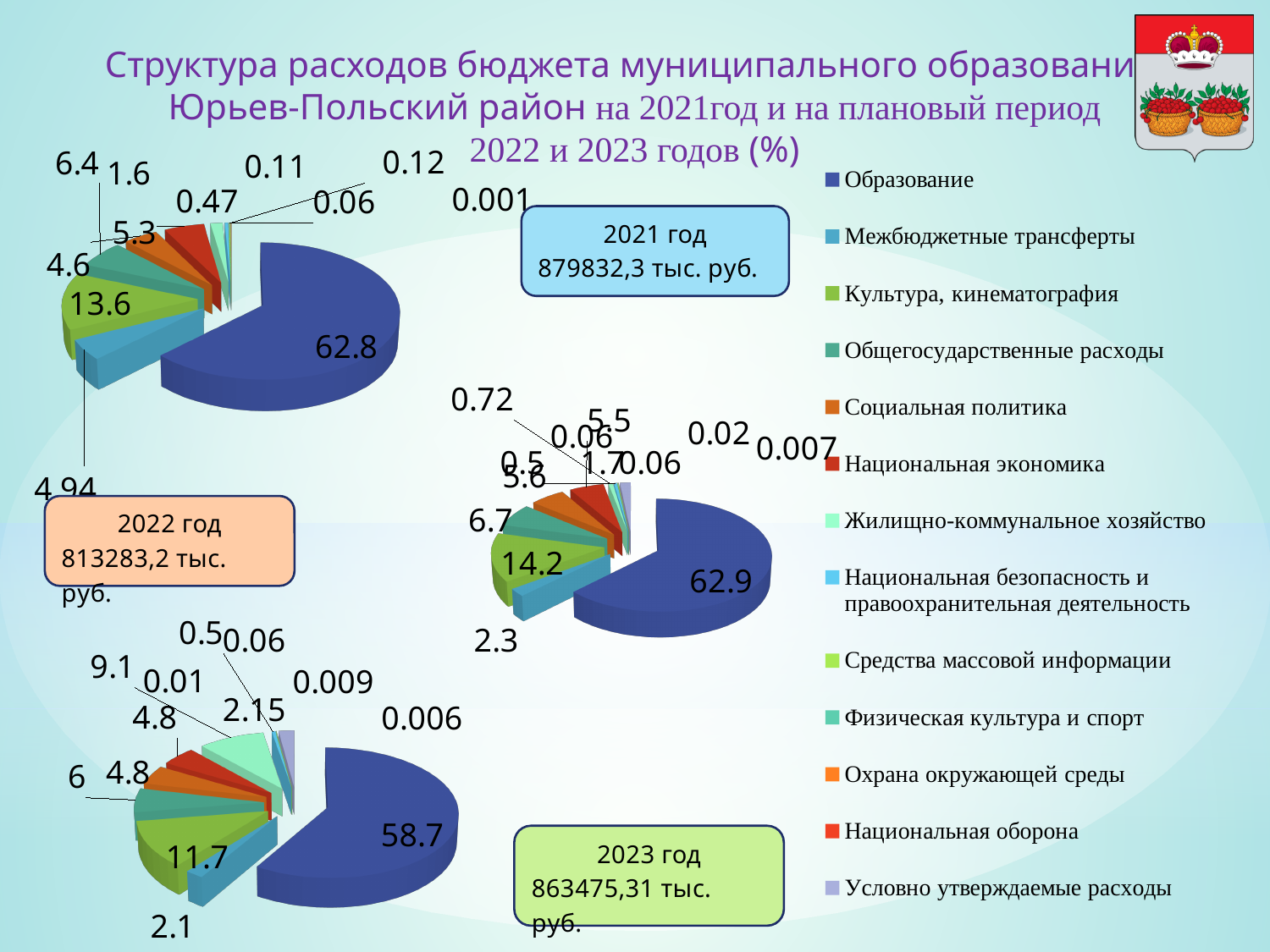
What total amount is shown in the box for 2021 год? 879832,3 тыс. руб. Which category has the largest slice in the 2023 год pie chart? Образование Which of the three pie charts shows the lowest share for Образование? 2023 год What kind of charts are shown on the slide? Pie charts What is the first entry in the legend? Образование In the 2023 год pie chart, what is the value of the largest slice (Образование)? 58.7 In the 2022 год pie chart, what is the value of the largest slice (Образование)? 62.9 In the 2021 год pie chart, what is the value of the largest slice (Образование)? 62.8 In the 2022 год pie chart, what value is labelled on the green slice (Культура, кинематография)? 14.2 What is the difference between the Образование share in the 2022 год chart (62.9) and in the 2023 год chart (58.7)? 4.2 How many entries does the legend list? 13 Is the Образование share larger in the 2021 год chart or in the 2023 год chart? 2021 год